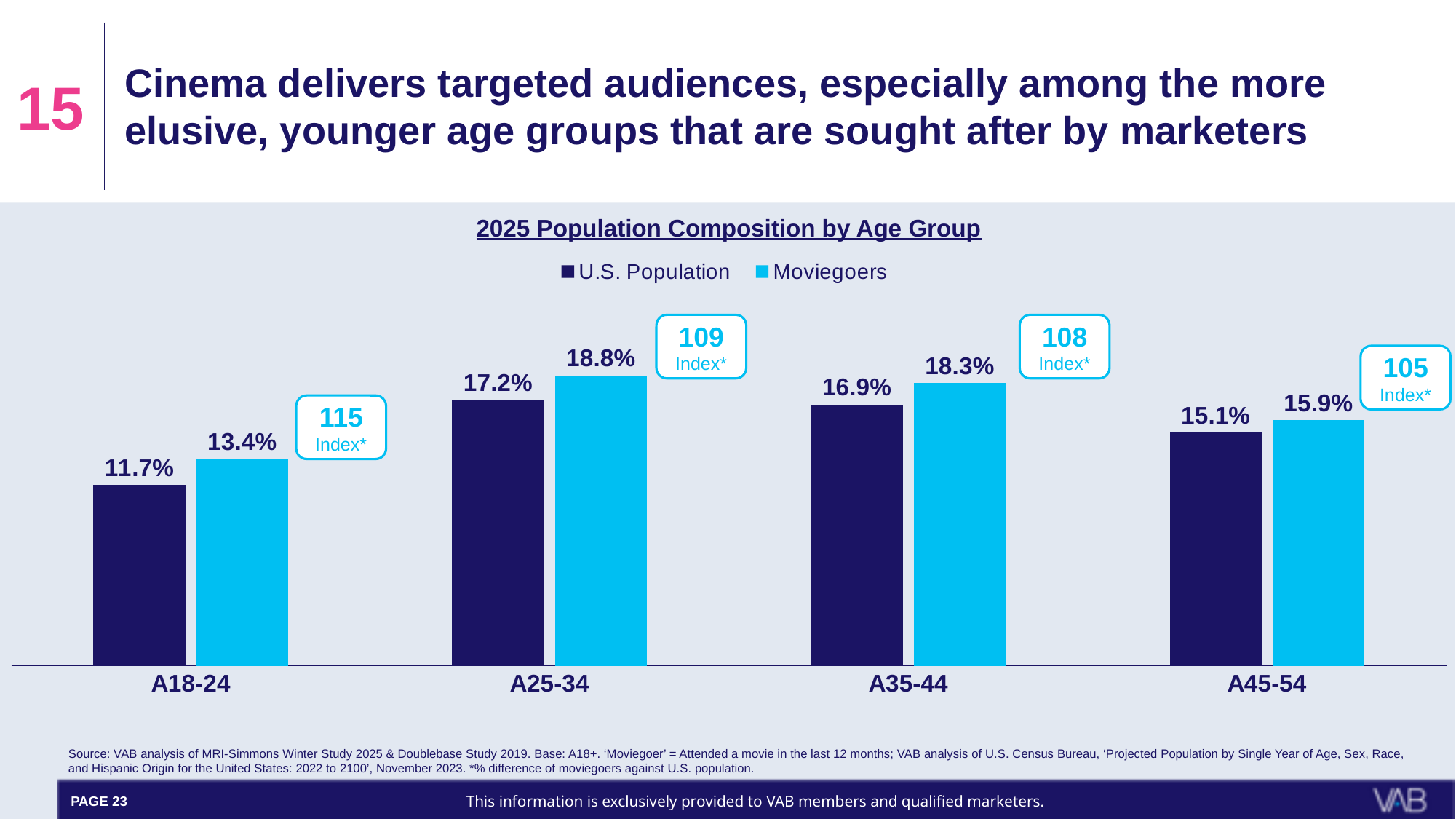
What is the Moviegoers value for A25-34? 18.8% What is the Moviegoers value for A45-54? 15.9% Which is larger for A35-44, the U.S. Population value or the Moviegoers value? Moviegoers How many age groups are shown on the x axis? 4 Which age group has the highest Moviegoers value? A25-34 What is the title of the chart? 2025 Population Composition by Age Group What is the U.S. Population value for A18-24? 11.7% What kind of chart is shown on the slide? Bar chart Which age group has the lowest U.S. Population value? A18-24 How many series does the legend list? 2 What is the difference between the Moviegoers and U.S. Population values for A18-24? 1.7% What is the index shown for A35-44? 108